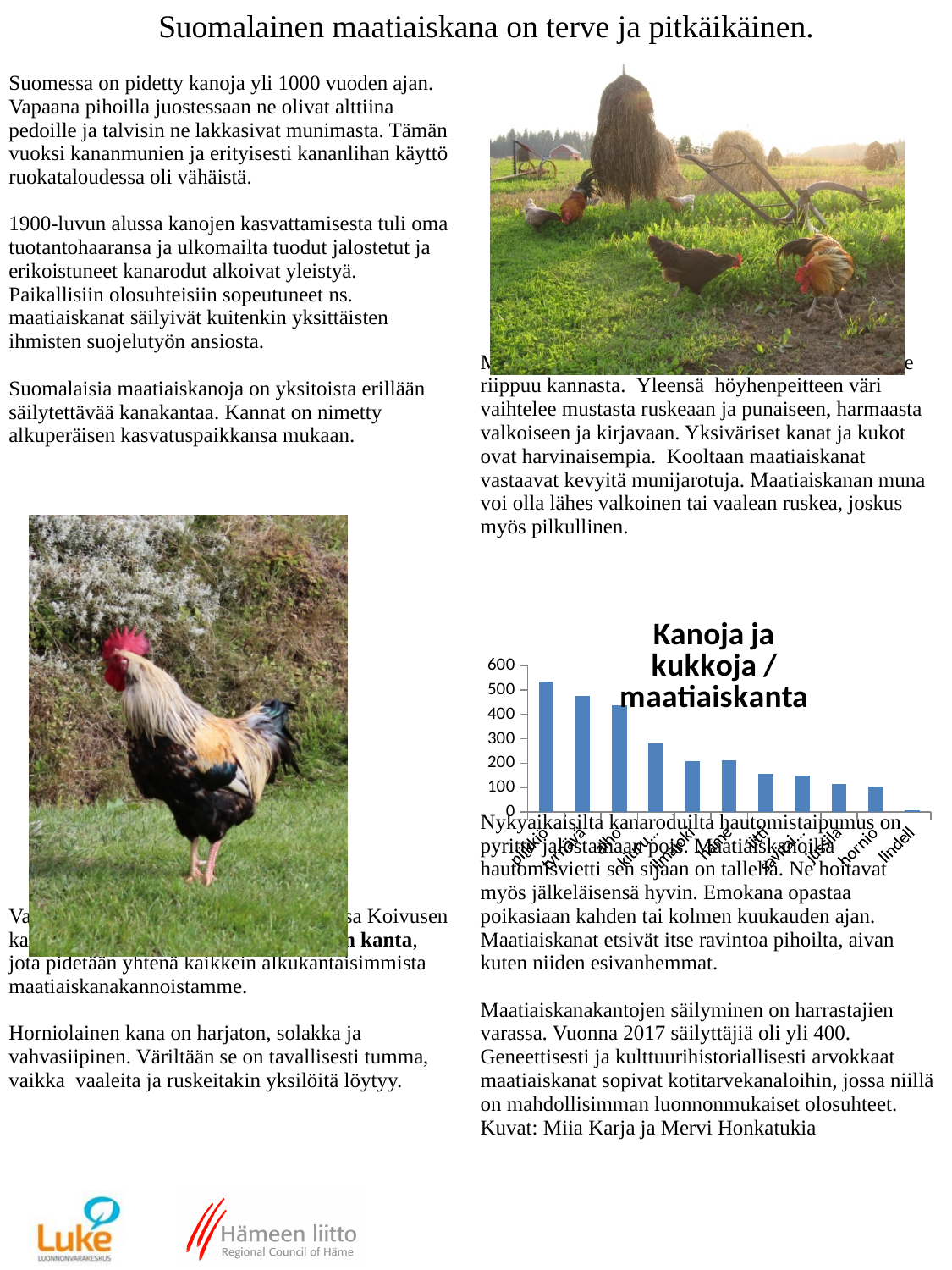
Is the value for lindell greater or less than 100? less What type of chart is shown on the slide? bar chart Which has a larger value, hornio or lindell? hornio How many bars does the chart show? 11 Do the bar values generally rise or fall from left to right along the x axis? fall Which bar in the chart is the highest? the first (leftmost) bar What is the title of the chart on the slide? Kanoja ja kukkoja / maatiaiskanta Which bar in the chart is the lowest? lindell What is the highest value shown on the chart's vertical axis? 600 Is the value of the first (leftmost) bar in the chart greater or less than 500? greater Is the value for hornio greater or less than 200? less